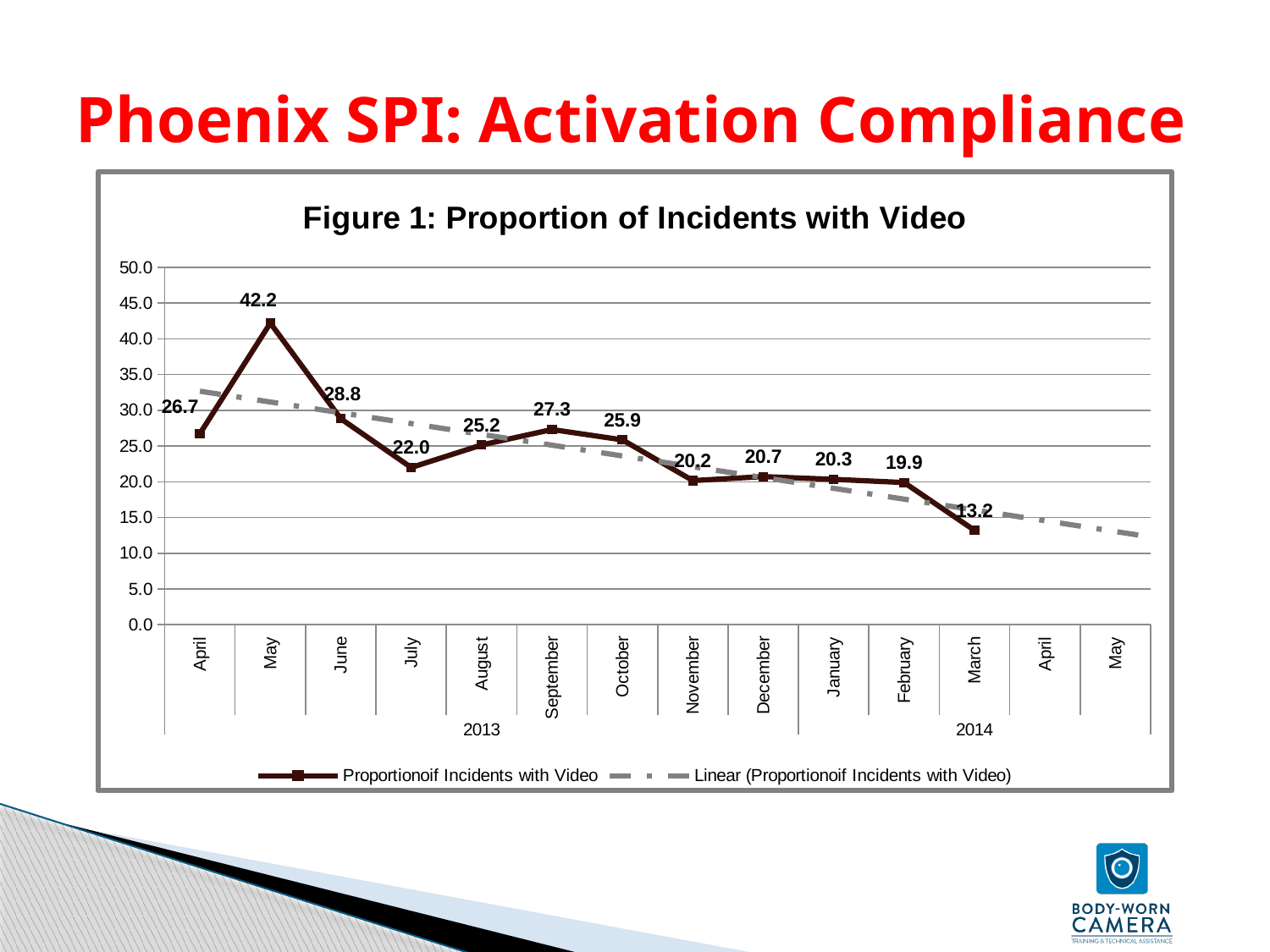
Which month has the lowest proportion of incidents with video? March 2014 What kind of chart is shown? line chart What is the proportion of incidents with video for May 2013? 42.2 Which month has the highest proportion of incidents with video? May 2013 What is the value plotted for September 2013? 27.3 What is the difference between the values for May 2013 and June 2013? 13.4 How many entries does the legend list? 2 What is the proportion of incidents with video for March 2014? 13.2 How many months have a plotted data value on the chart? 12 Which is larger, the value for August 2013 or the value for October 2013? October 2013 Is the value for July 2013 greater or less than 25.0? less Does the linear trend line rise or fall from left to right? fall